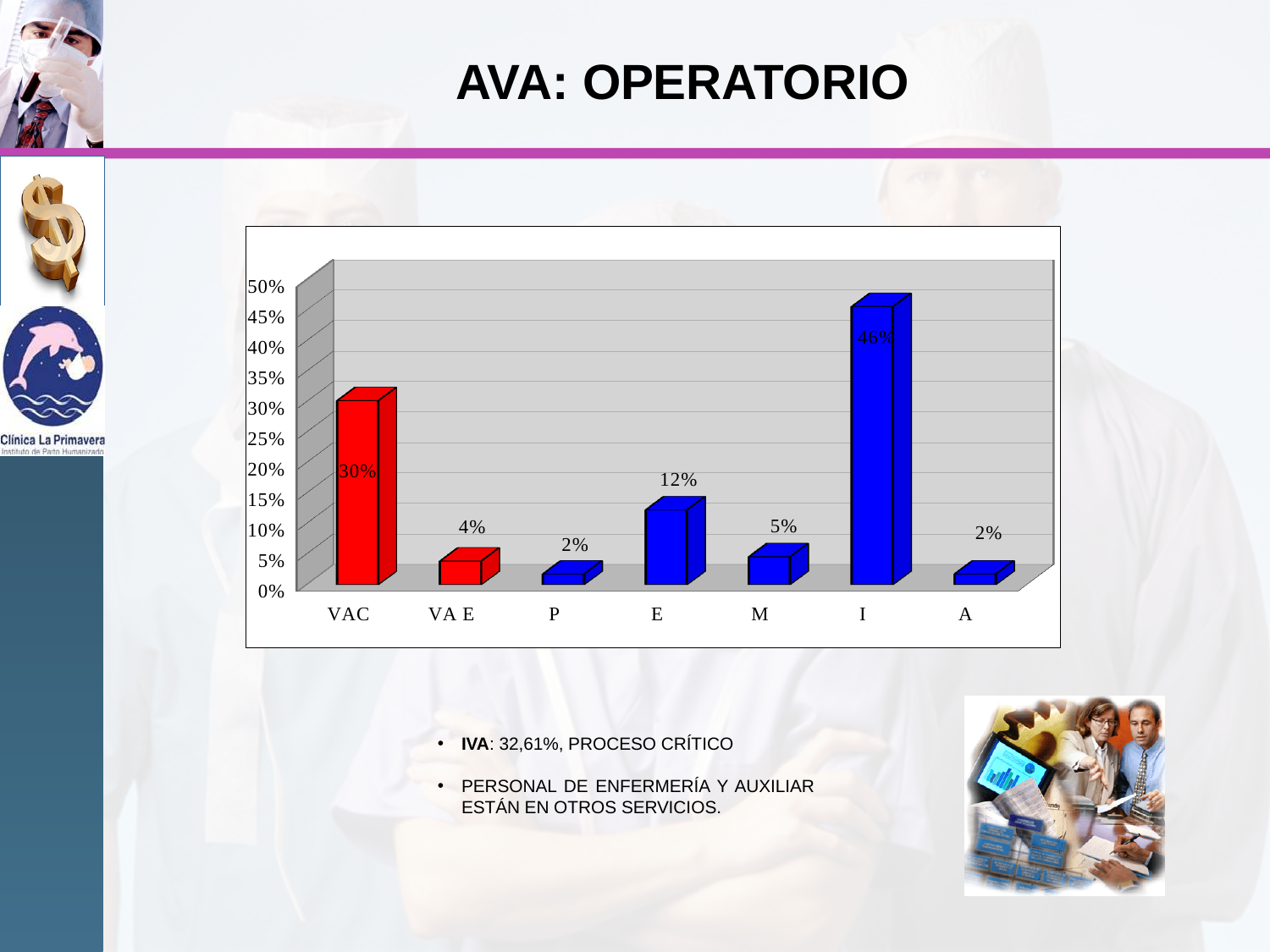
What is the value for VAC? 30% What is the difference between the values for E and P? 10% Is the value for I greater or less than 40%? greater Which category has the highest value? I What is the difference between the values for I and VAC? 16% What is the value for E? 12% What is the value for M? 5% What colour are the bars for VAC and VA E? red How many categories are shown on the x axis? 7 What is the value for I? 46% What kind of chart is shown? bar chart Which is larger, the value for E or the value for VA E? E